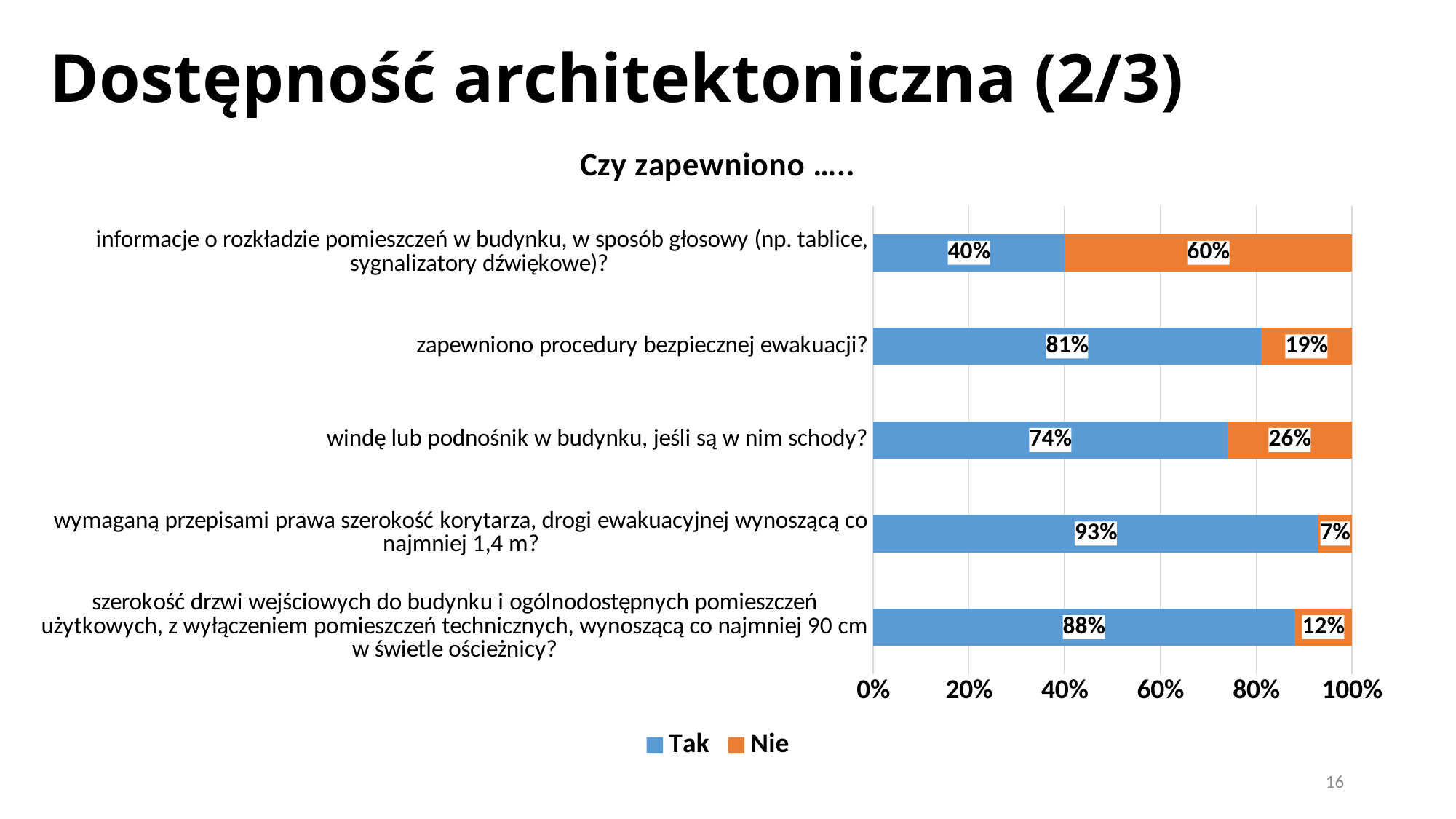
What is the 'Nie' value for 'windę lub podnośnik w budynku, jeśli są w nim schody?'? 26% What is the difference between the 'Tak' and 'Nie' values for 'zapewniono procedury bezpiecznej ewakuacji?'? 62% What is the 'Nie' value for the category about voice information on the layout of rooms in the building? 60% What is the 'Tak' value for 'zapewniono procedury bezpiecznej ewakuacji?'? 81% Which category has the lowest 'Tak' value? informacje o rozkładzie pomieszczeń w budynku, w sposób głosowy (np. tablice, sygnalizatory dźwiękowe)? How many series does the legend list? 2 What is the title of the chart? Czy zapewniono ….. How many categories are shown in the chart? 5 Which is larger: the 'Tak' value for the door width category (90 cm) or the 'Tak' value for the lift/hoist category? the door width category (88%) What is the 'Tak' value for the category about corridor width of at least 1,4 m? 93% What kind of chart is shown on the slide? stacked bar chart Which category has the highest 'Tak' value? wymaganą przepisami prawa szerokość korytarza, drogi ewakuacyjnej wynoszącą co najmniej 1,4 m?